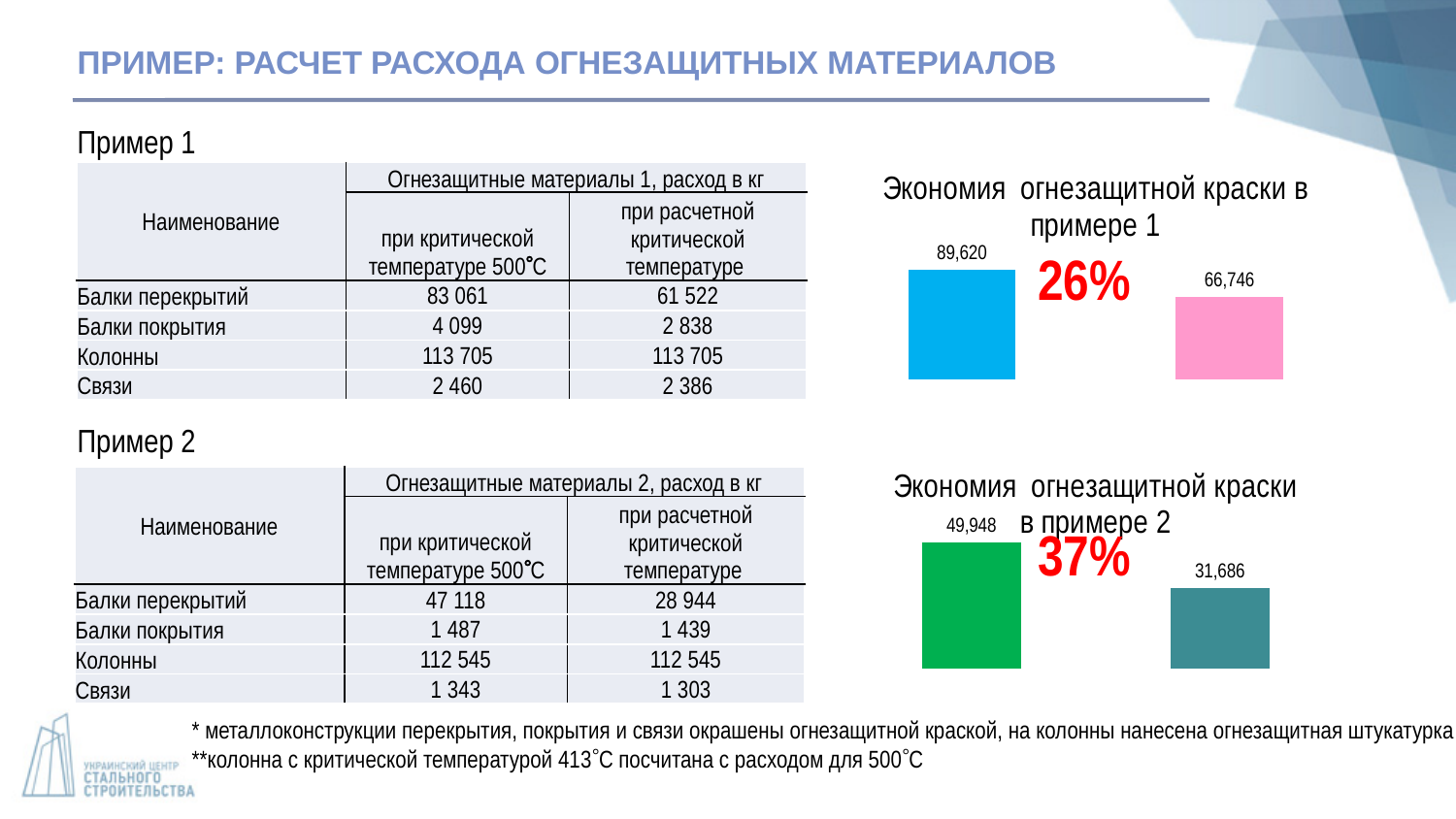
What type of chart is used for "Экономия огнезащитной краски в примере 2"? bar chart In the chart for example 1 (upper right), which bar is taller, the left or the right one? the left one In the chart titled "Экономия огнезащитной краски в примере 1", what value is shown on the left (blue) bar? 89,620 In the chart titled "Экономия огнезащитной краски в примере 1", what is the difference between the two bar values? 22,874 What percentage is printed in red between the bars of the chart for example 2? 37% How many bars does the chart for example 1 (upper right) contain? 2 In the chart titled "Экономия огнезащитной краски в примере 2", what value is shown on the left (green) bar? 49,948 In the chart titled "Экономия огнезащитной краски в примере 1", what value is shown on the right (pink) bar? 66,746 In the chart for example 2 (lower right), which bar is shorter, the left or the right one? the right one In the chart titled "Экономия огнезащитной краски в примере 2", what value is shown on the right (teal) bar? 31,686 What percentage is printed in red between the bars of the chart for example 1? 26% In the chart titled "Экономия огнезащитной краски в примере 2", what is the difference between the two bar values? 18,262